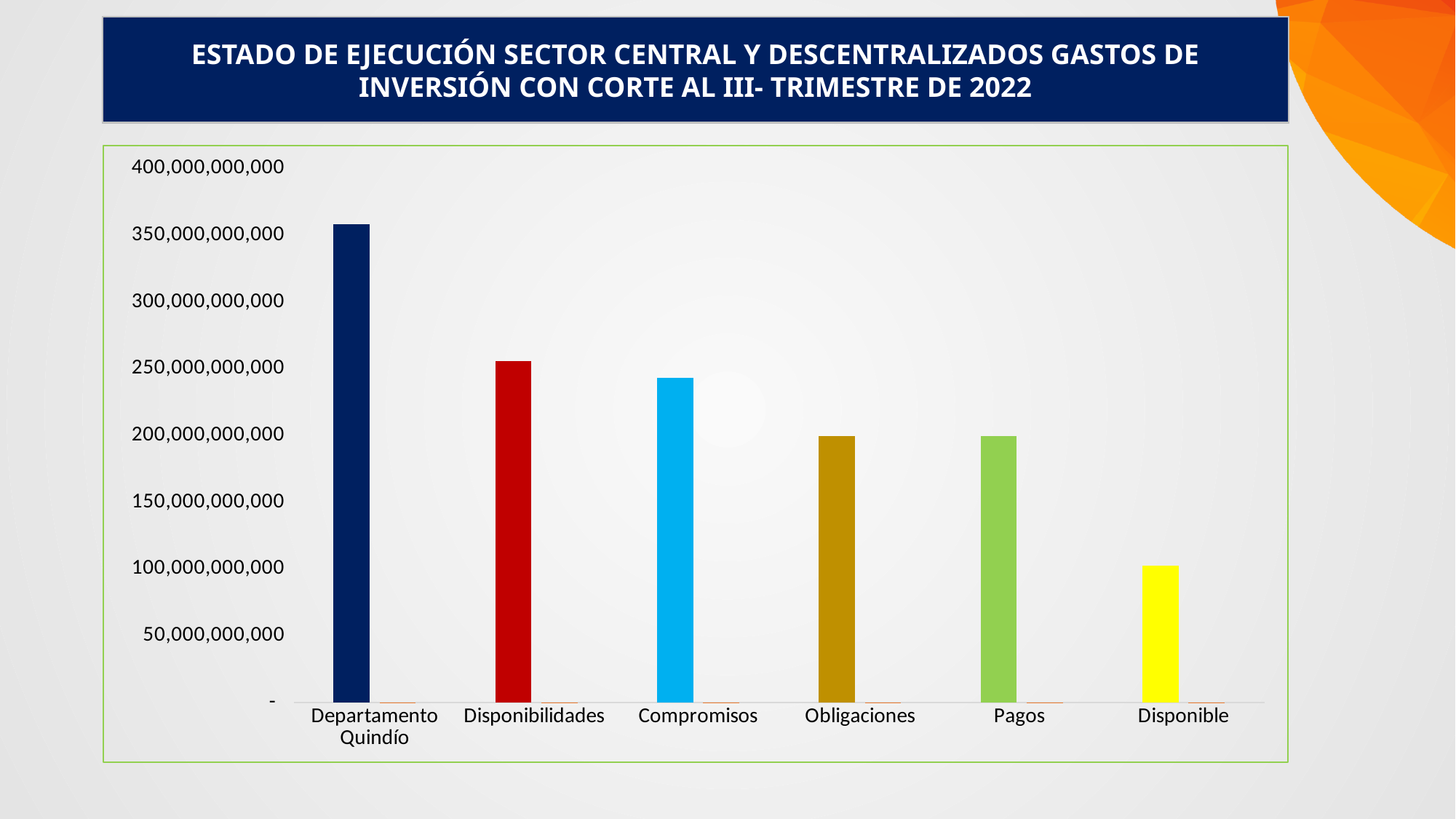
Is the value for Disponible greater or less than 150,000,000,000? less Do the values generally rise or fall from left to right along the x axis? fall What kind of chart is shown on the slide? bar chart Is the value for Disponibilidades greater or less than 250,000,000,000? greater Which is larger, the value for Disponibilidades or the value for Compromisos? Disponibilidades How many categories are plotted on the x axis? 6 What colour is the bar for Compromisos? light blue Which category has the highest value? Departamento Quindío Which is larger, the value for Pagos or the value for Disponible? Pagos Is the value for Compromisos greater or less than 250,000,000,000? less Which category has the lowest value? Disponible